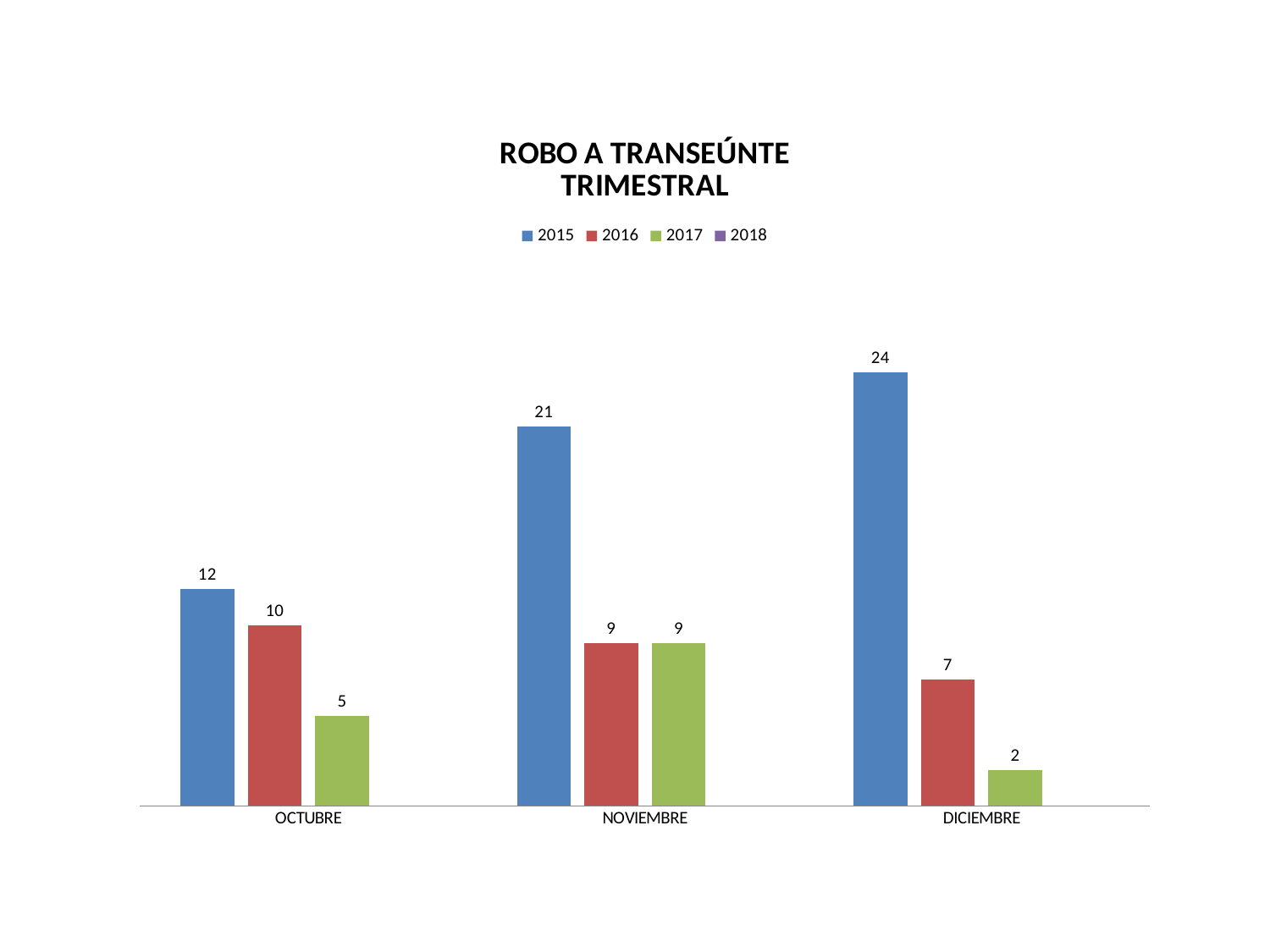
Does the 2017 series rise or fall from NOVIEMBRE to DICIEMBRE? fall How many series does the legend list? 4 Which is larger, the 2016 value in OCTUBRE or the 2016 value in DICIEMBRE? OCTUBRE What kind of chart is this? bar chart What is the difference between the 2015 values for NOVIEMBRE and OCTUBRE? 9 How many months are shown on the x axis? 3 What is the value for 2015 in OCTUBRE? 12 In which month is the 2015 value highest? DICIEMBRE What is the value for 2016 in NOVIEMBRE? 9 What is the difference between the 2015 and 2016 values in DICIEMBRE? 17 In which month is the 2017 value lowest? DICIEMBRE What is the value for 2017 in DICIEMBRE? 2